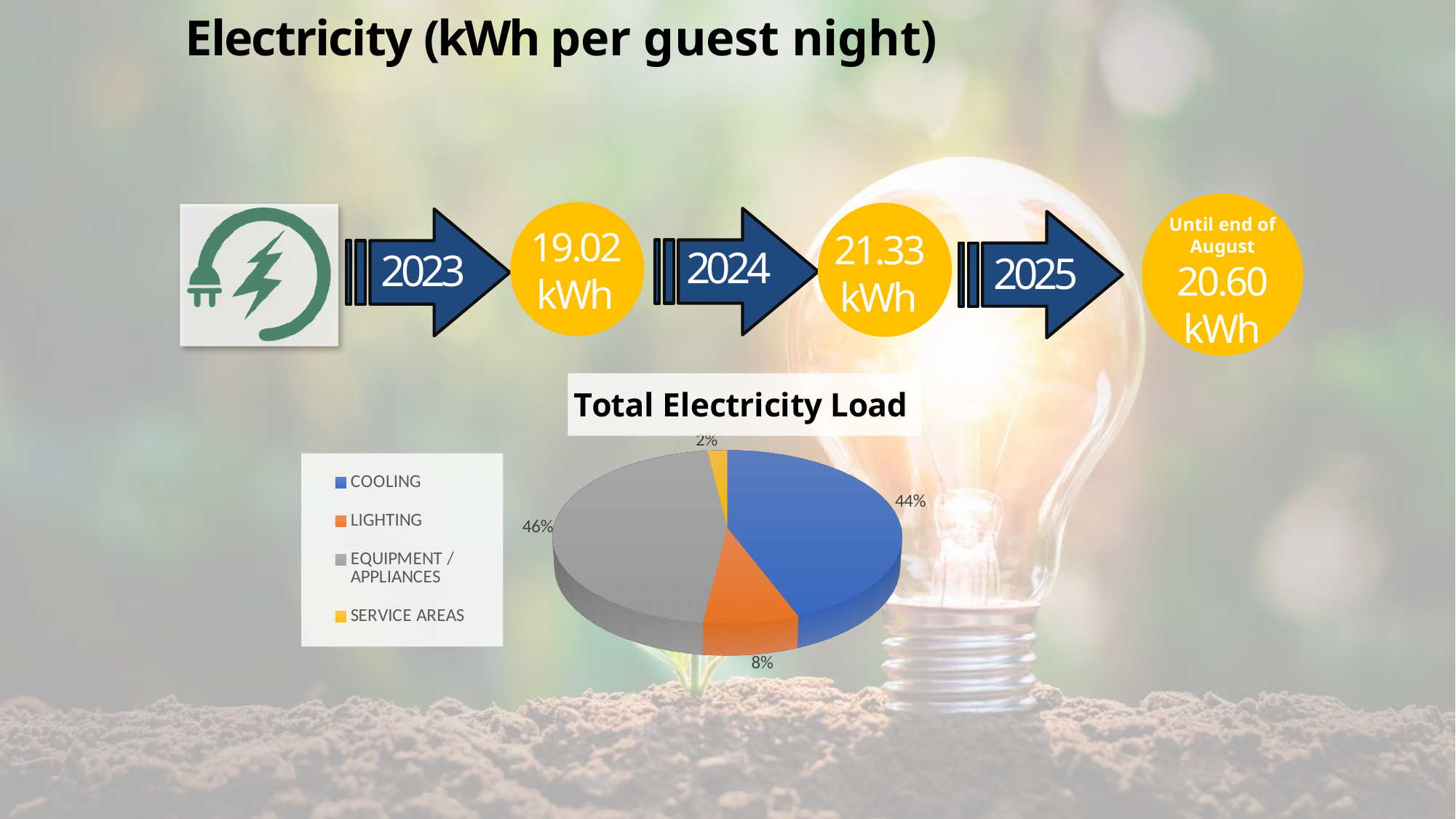
In the "Total Electricity Load" pie chart, what is the difference in percentage points between Cooling and Lighting? 36 In the "Total Electricity Load" pie chart, what share does Service Areas account for? 2% How many categories does the "Total Electricity Load" pie chart show? 4 What type of chart is the "Total Electricity Load" chart? pie chart In the "Total Electricity Load" pie chart, what share does Cooling account for? 44% Which category has the smallest slice in the "Total Electricity Load" pie chart? Service Areas What is the title of the pie chart on the slide? Total Electricity Load Which category has the largest slice in the "Total Electricity Load" pie chart? Equipment / Appliances In the "Total Electricity Load" pie chart, which is larger: Cooling or Lighting? Cooling In the "Total Electricity Load" pie chart, what share does Equipment / Appliances account for? 46% In the "Total Electricity Load" pie chart, what colour is the Equipment / Appliances slice? grey